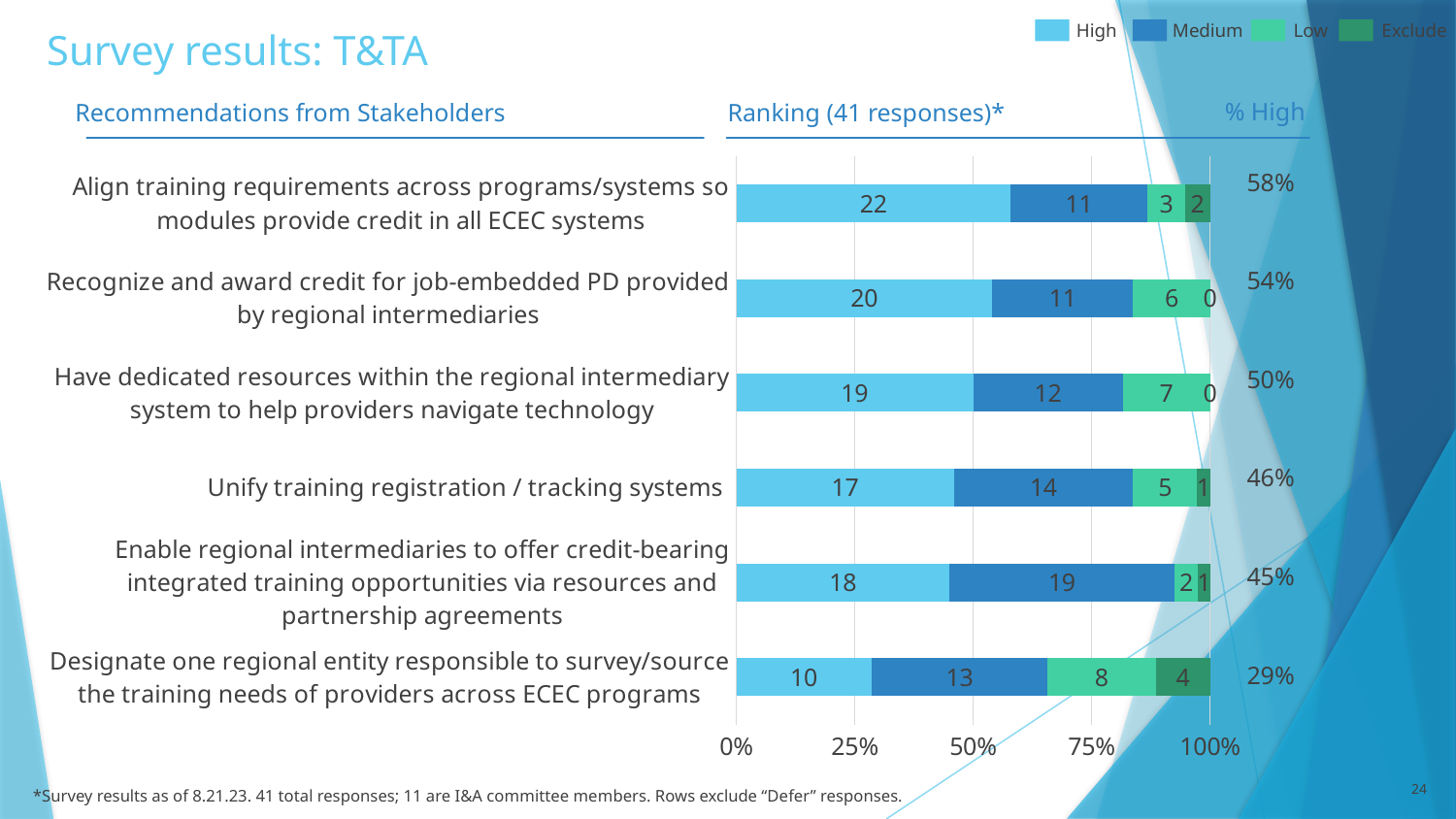
What is the High value for "Align training requirements across programs/systems so modules provide credit in all ECEC systems"? 22 Which is larger for "Unify training registration / tracking systems": the High value or the Medium value? High What type of chart is shown on the slide? Stacked bar chart How many series does the legend list? 4 What is the Medium value for "Enable regional intermediaries to offer credit-bearing integrated training opportunities via resources and partnership agreements"? 19 How many recommendation categories are plotted in the chart? 6 What is the Exclude value for "Designate one regional entity responsible to survey/source the training needs of providers across ECEC programs"? 4 What is the difference between the High values for "Recognize and award credit for job-embedded PD provided by regional intermediaries" and "Unify training registration / tracking systems"? 3 Which recommendation has the lowest High value? Designate one regional entity responsible to survey/source the training needs of providers across ECEC programs What is the total of all segments in the bar for "Have dedicated resources within the regional intermediary system to help providers navigate technology"? 38 Which recommendation has the highest High value? Align training requirements across programs/systems so modules provide credit in all ECEC systems What % High is shown for "Unify training registration / tracking systems"? 46%